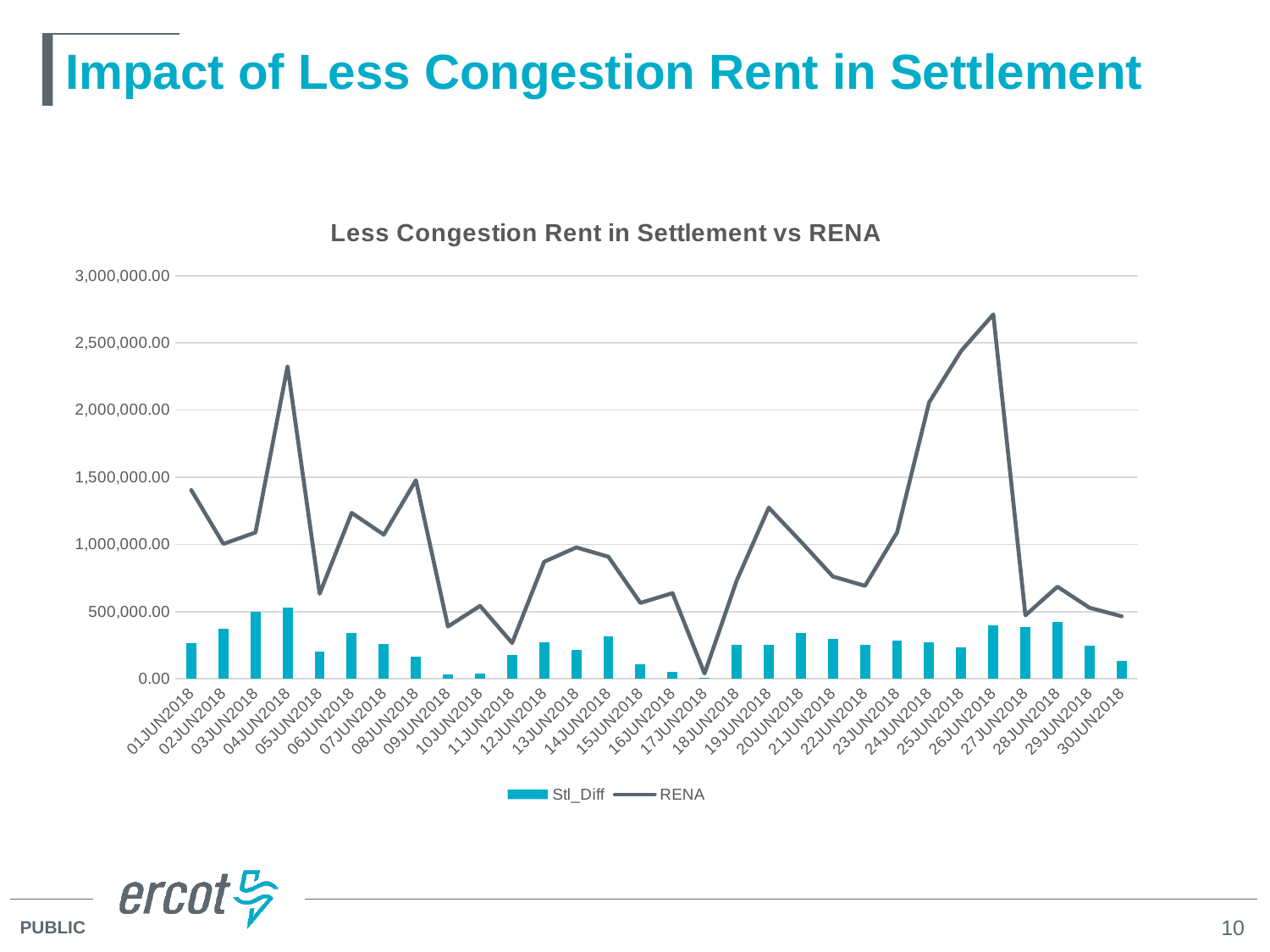
Does the RENA line rise or fall from 23JUN2018 to 26JUN2018? rise Is the Stl_Diff value for 02JUN2018 greater or less than 500,000.00? less On which date is the Stl_Diff bar the tallest? 04JUN2018 Is the RENA value for 04JUN2018 greater or less than 2,000,000.00? greater On which date does the RENA line reach its lowest value? 17JUN2018 What kind of chart is shown on the slide? A combination bar and line chart Is the RENA value for 26JUN2018 greater or less than 2,500,000.00? greater On which date does the RENA line reach its highest value? 26JUN2018 What are the two series named in the legend? Stl_Diff and RENA Which date has the higher RENA value, 04JUN2018 or 08JUN2018? 04JUN2018 How many series does the legend list? 2 How many dates are shown along the x axis? 30